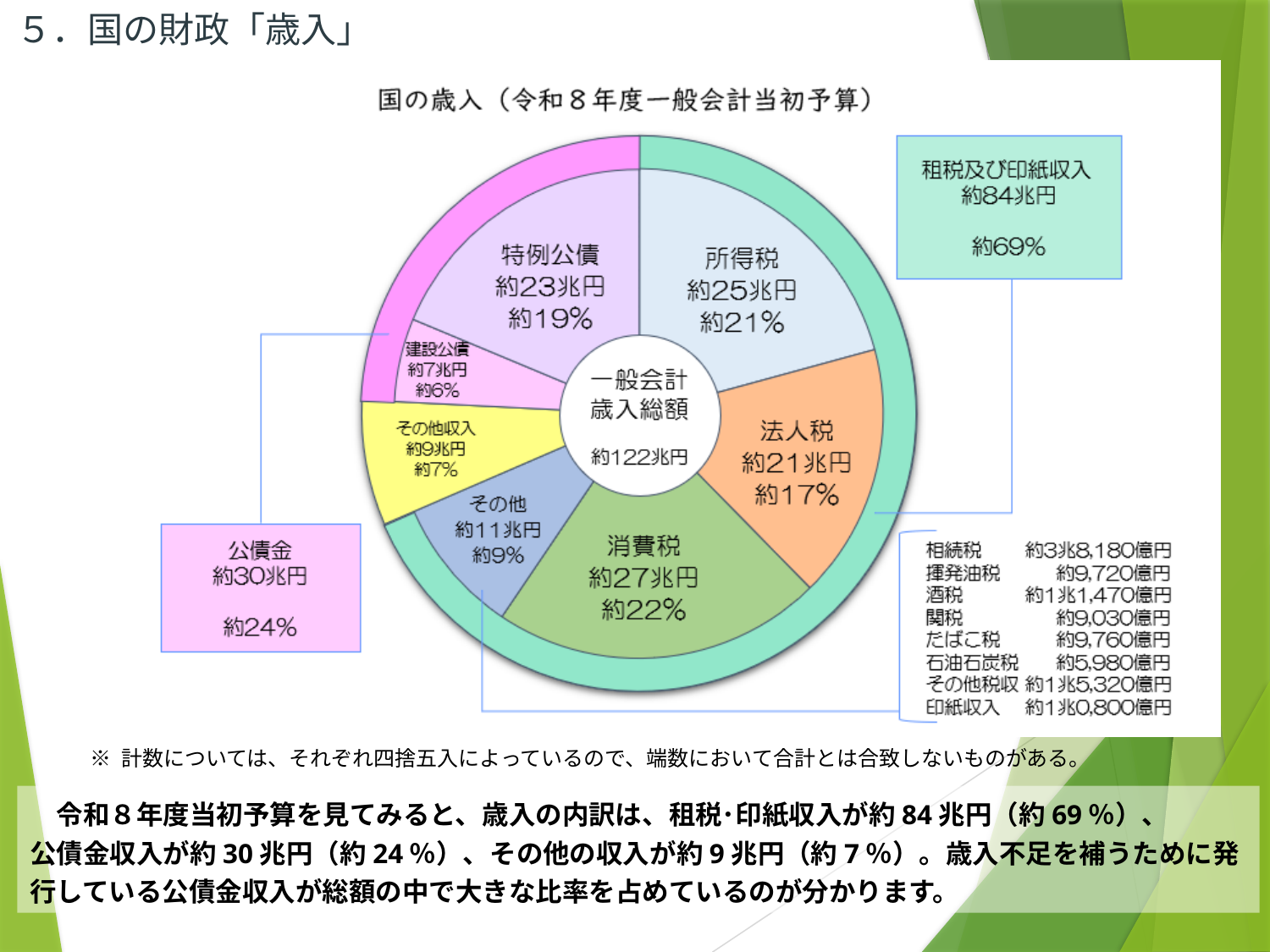
Which is larger, 所得税 or 法人税? 所得税 What kind of chart is shown on the slide? Pie chart What is the value shown for 法人税? 約21兆円 What share of the total does 消費税 account for? 約22% What is the value shown for 所得税? 約25兆円 What is the value shown for 特例公債? 約23兆円 What is the title of the chart? 国の歳入（令和８年度一般会計当初予算） How many inner slices does the chart have? 7 Which inner slice of the chart has the largest value? 消費税 What is the total revenue (一般会計歳入総額) shown in the centre of the chart? 約122兆円 Which inner slice of the chart has the smallest value? 建設公債 What share of the total does 公債金 account for? 約24%